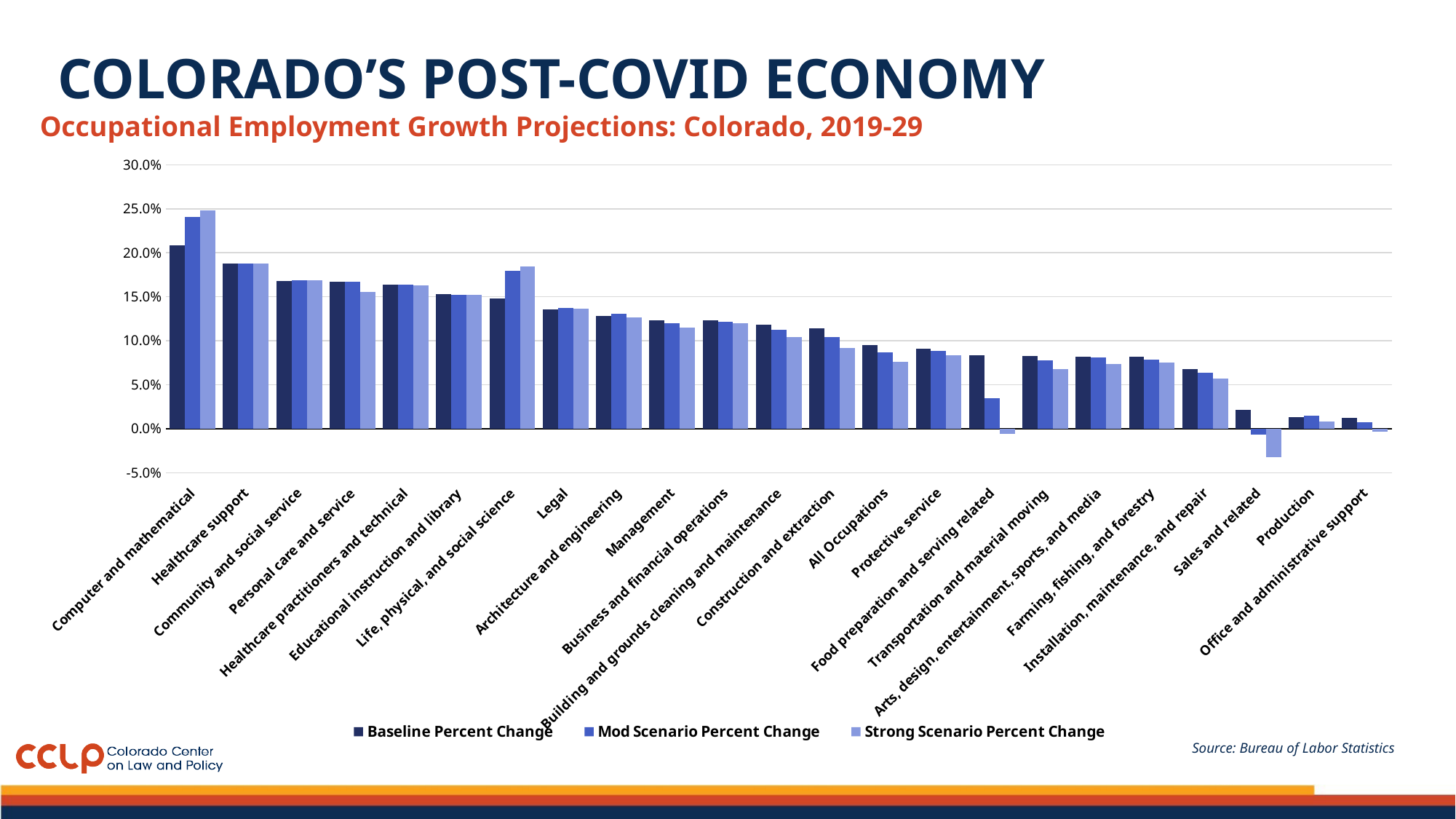
Which category has the lowest value in the chart? Sales and related Is the Baseline Percent Change value for Computer and mathematical greater or less than 20.0%? greater Is the Baseline Percent Change value for Legal greater or less than 15.0%? less What is the source cited for the chart? Bureau of Labor Statistics For Food preparation and serving related, which is larger: the Baseline Percent Change or the Strong Scenario Percent Change? Baseline Percent Change Is the Strong Scenario Percent Change value for Sales and related greater or less than 0.0%? less How many series does the legend list? 3 Which category has the highest value in the chart? Computer and mathematical How many occupational categories are shown on the x axis? 23 What kind of chart is shown on the slide? Bar chart Do the Baseline Percent Change values generally rise or fall moving from left to right along the x axis? Fall